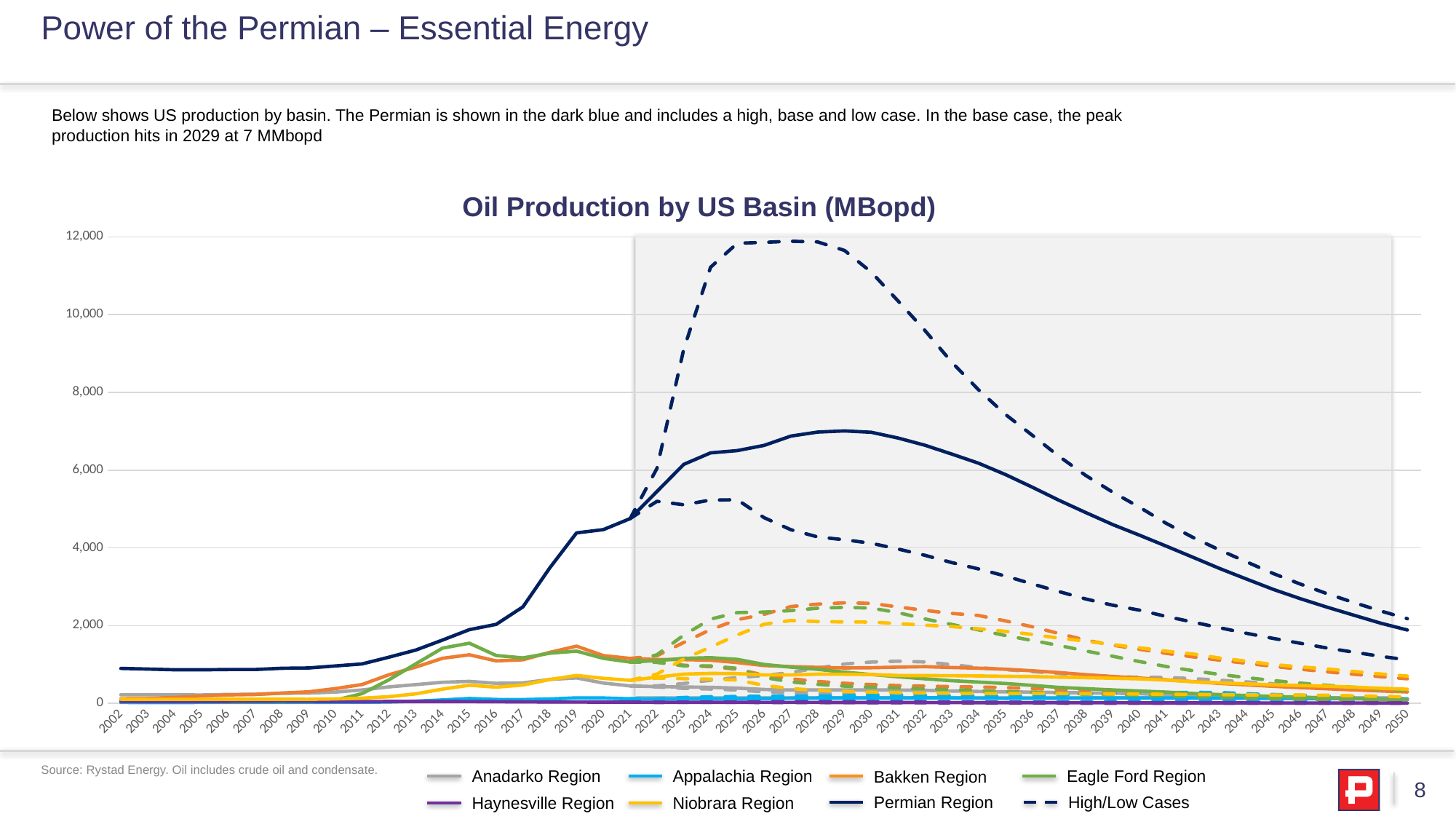
What is the title of the chart? Oil Production by US Basin (MBopd) Which region has the highest oil production in 2050? Permian Region Which region is plotted with the dark blue solid line? Permian Region How many years are shown on the x axis? 49 Is the Permian low case (lower dashed line) in 2050 greater or less than 2,000? less Is the value for the Permian Region in 2002 greater or less than 2,000? less In 2019, which is larger: the Permian Region or the Eagle Ford Region? Permian Region Is the peak of the Permian high case (upper dashed line) greater or less than 10,000? greater How many series does the legend list? 8 What kind of chart is shown on the slide? line chart Does the Permian Region line rise or fall from 2029 to 2050? fall